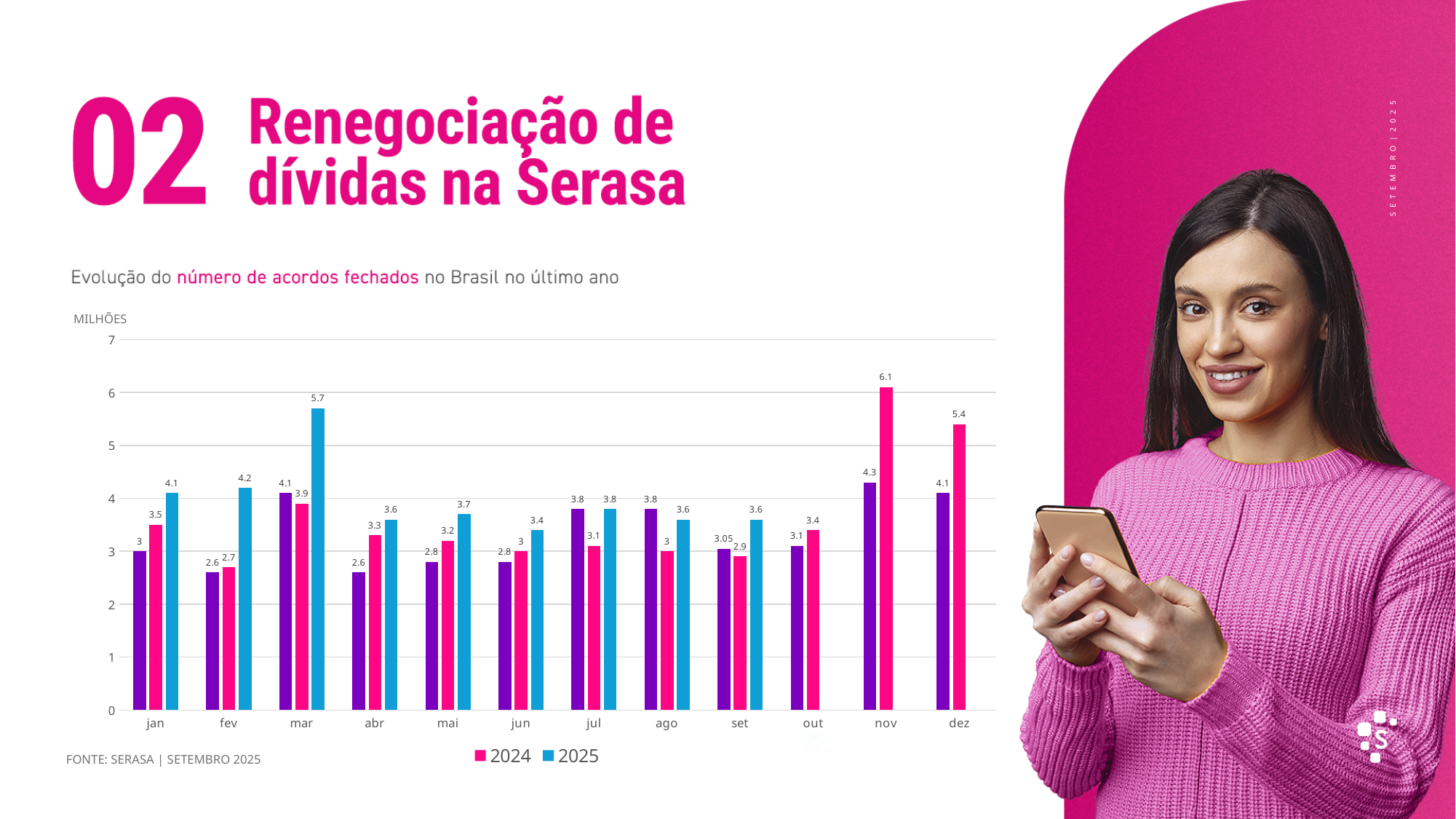
In which month is the 2024 value lowest? fev What kind of chart is shown on the slide? bar chart How many series does the legend list? 2 In which month is the 2024 value highest? nov What is the value for 2024 in set? 2.9 What is the difference between the 2025 and 2024 values in mar? 1.8 What is the value for 2025 in mar? 5.7 What is the value for 2024 in nov? 6.1 Which is larger in fev, the 2024 value or the 2025 value? 2025 How many months are shown on the x axis? 12 In which month is the 2025 value highest? mar What unit label is shown above the y axis? MILHÕES